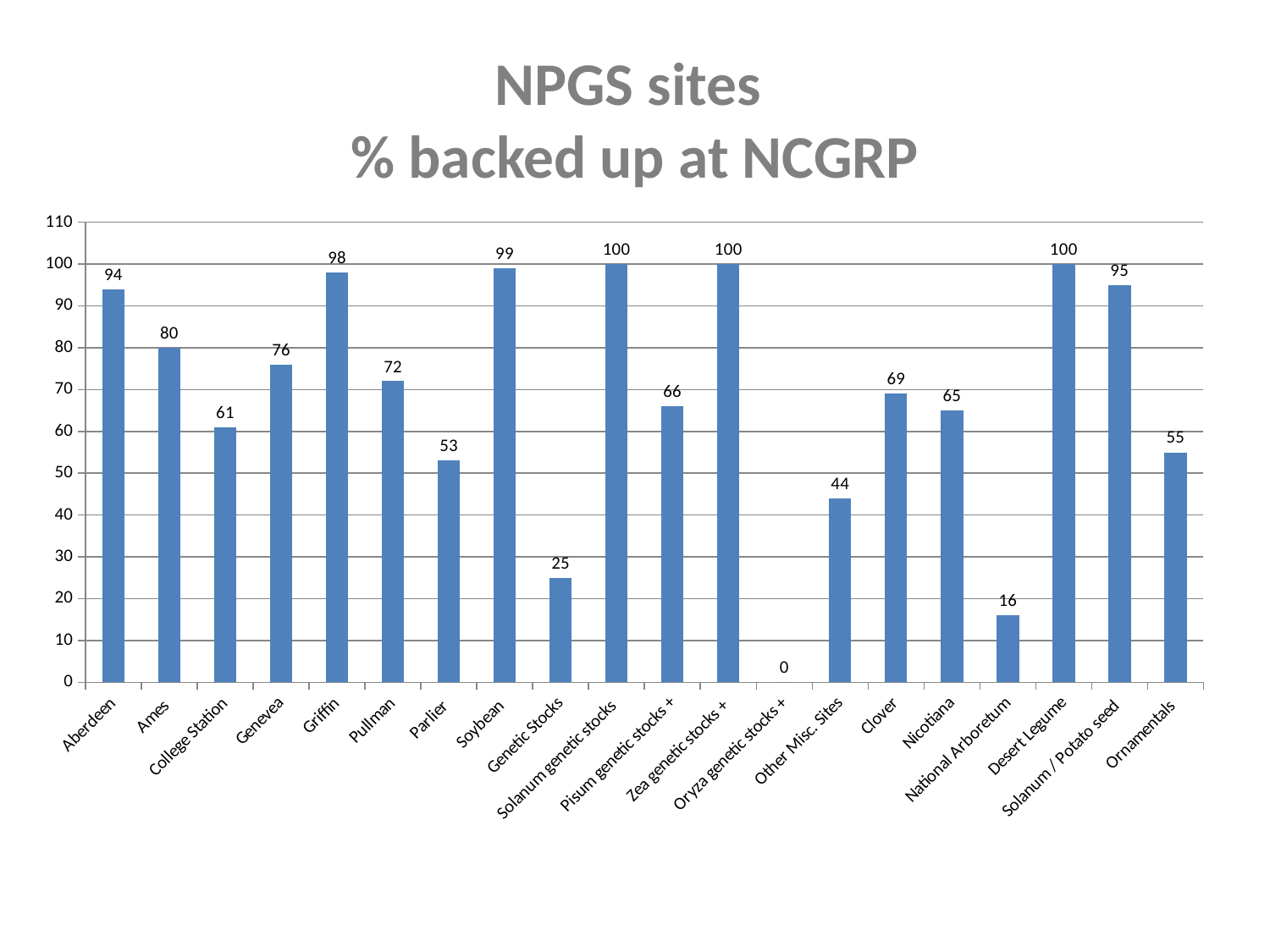
What is the difference between the values for Griffin and Parlier? 45 What is the difference between the values for Ames and Genetic Stocks? 55 What is the value for National Arboretum? 16 Which is larger, the value for Clover or the value for Nicotiana? Clover What is the value for Aberdeen? 94 How many categories are shown on the x axis? 20 What kind of chart is shown on the slide? Bar chart What is the value for Other Misc. Sites? 44 Which is larger, the value for College Station or the value for Ornamentals? College Station What is the value for Pullman? 72 Which category has the lowest value? Oryza genetic stocks + What is the title of the chart? NPGS sites % backed up at NCGRP